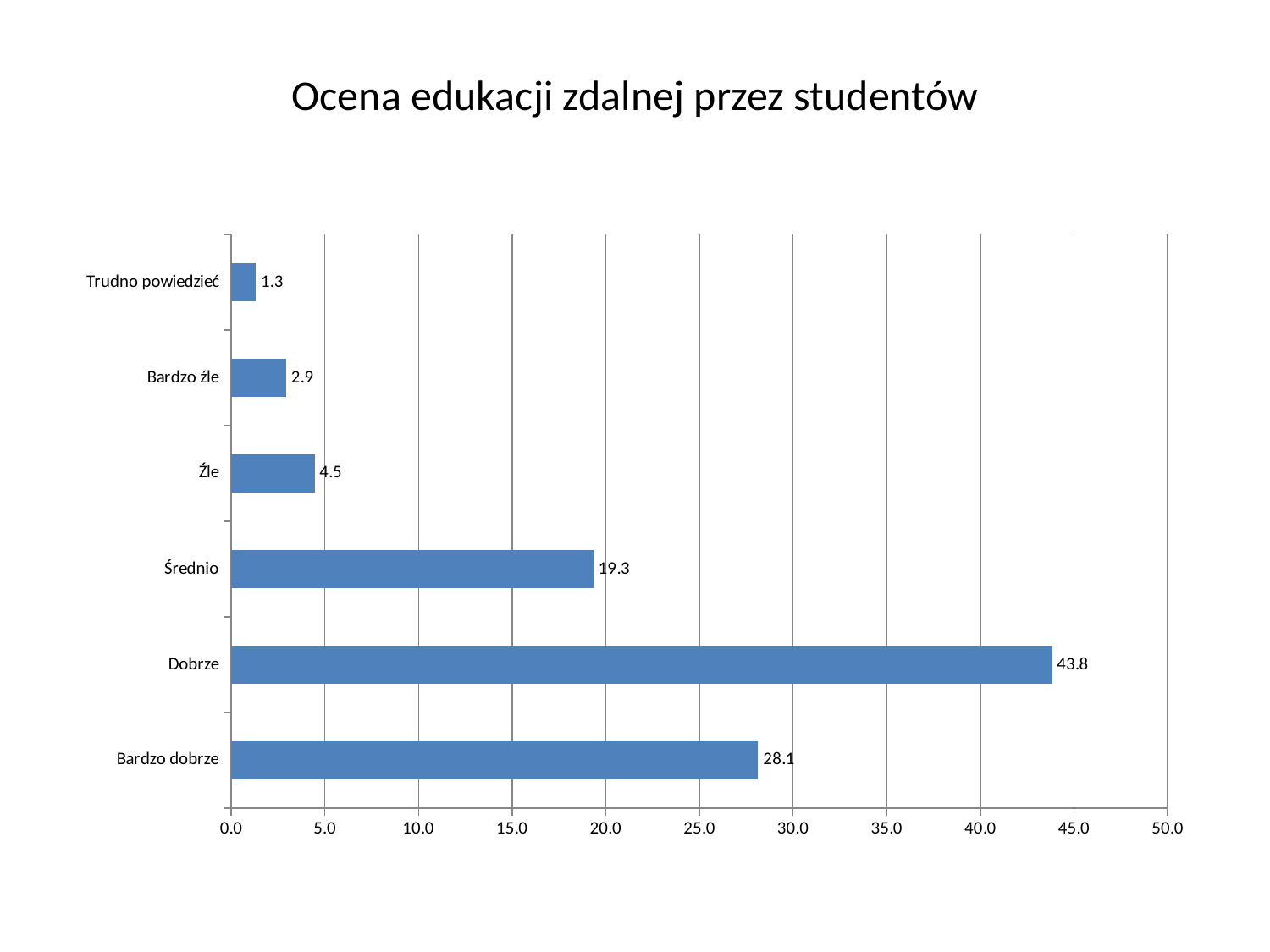
Which category has the lowest value? Trudno powiedzieć What is the value for Bardzo dobrze? 28.1 What is the value for Dobrze? 43.8 Is the value for Średnio greater or less than 20.0? less What kind of chart is shown on the slide? Bar chart How many categories are shown in the chart? 6 What is the value for Trudno powiedzieć? 1.3 Which is larger, the value for Źle or the value for Bardzo źle? Źle Which category has the highest value? Dobrze What is the value for Średnio? 19.3 What is the title of the chart? Ocena edukacji zdalnej przez studentów What is the difference between the values for Dobrze and Bardzo dobrze? 15.7